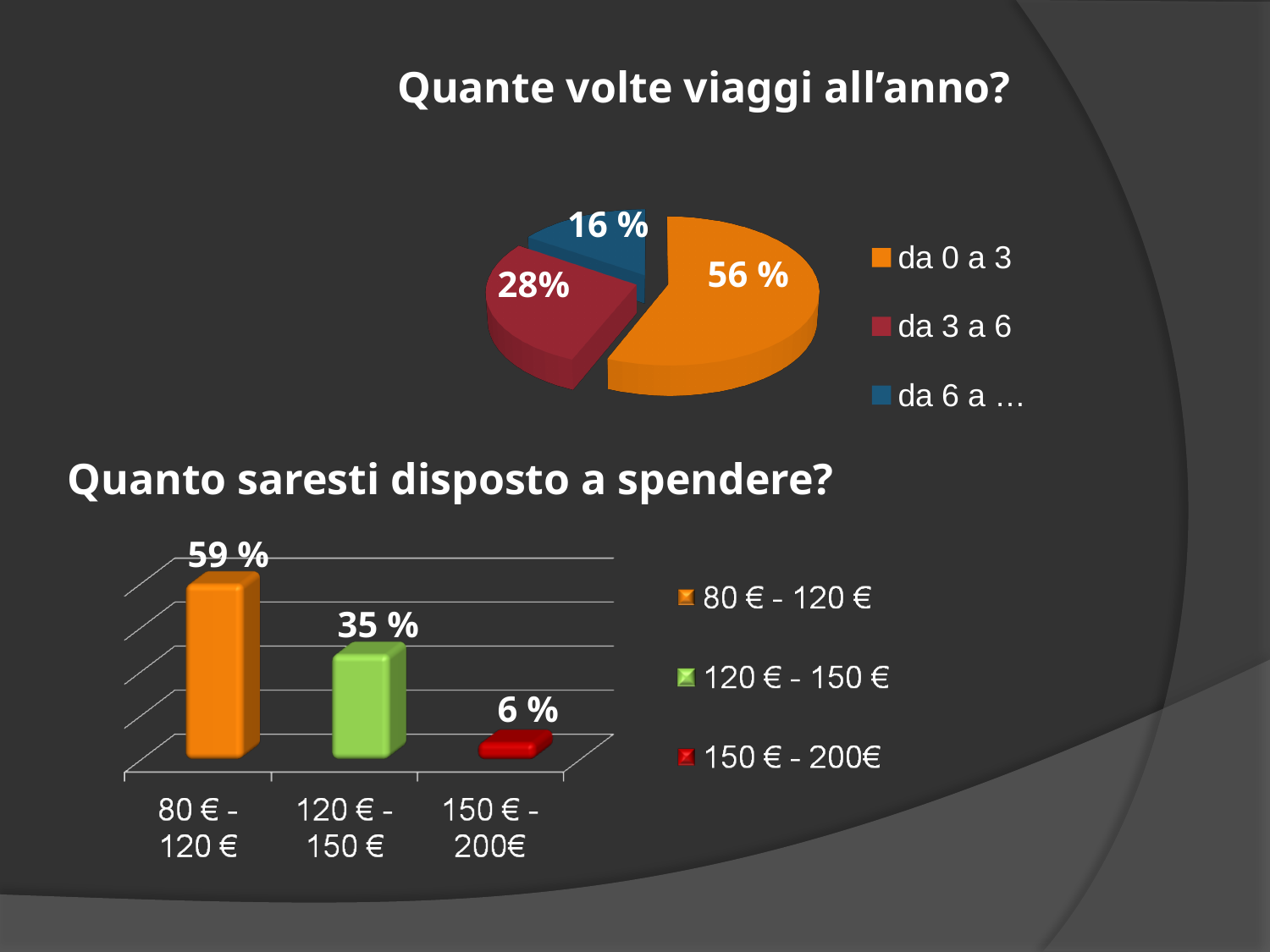
What kind of chart is the bottom chart 'Quanto saresti disposto a spendere?'? Bar chart In the pie chart 'Quante volte viaggi all'anno?', what is the difference between the 'da 0 a 3' and 'da 3 a 6' values? 28 percentage points In the pie chart 'Quante volte viaggi all'anno?', how many slices are there? 3 What kind of chart is the top chart 'Quante volte viaggi all'anno?'? Pie chart In the bar chart 'Quanto saresti disposto a spendere?', what is the difference between the '80 € - 120 €' and '150 € - 200€' values? 53 percentage points In the pie chart 'Quante volte viaggi all'anno?', what is the value for 'da 3 a 6'? 28% In the pie chart 'Quante volte viaggi all'anno?', which category has the smallest slice? da 6 a … In the bar chart 'Quanto saresti disposto a spendere?', which category has the highest value? 80 € - 120 € In the pie chart 'Quante volte viaggi all'anno?', what is the value for 'da 0 a 3'? 56 % In the bar chart 'Quanto saresti disposto a spendere?', do the values rise or fall from left to right along the x axis? Fall In the pie chart 'Quante volte viaggi all'anno?', which category has the largest slice? da 0 a 3 In the bar chart 'Quanto saresti disposto a spendere?', what is the value for '120 € - 150 €'? 35 %